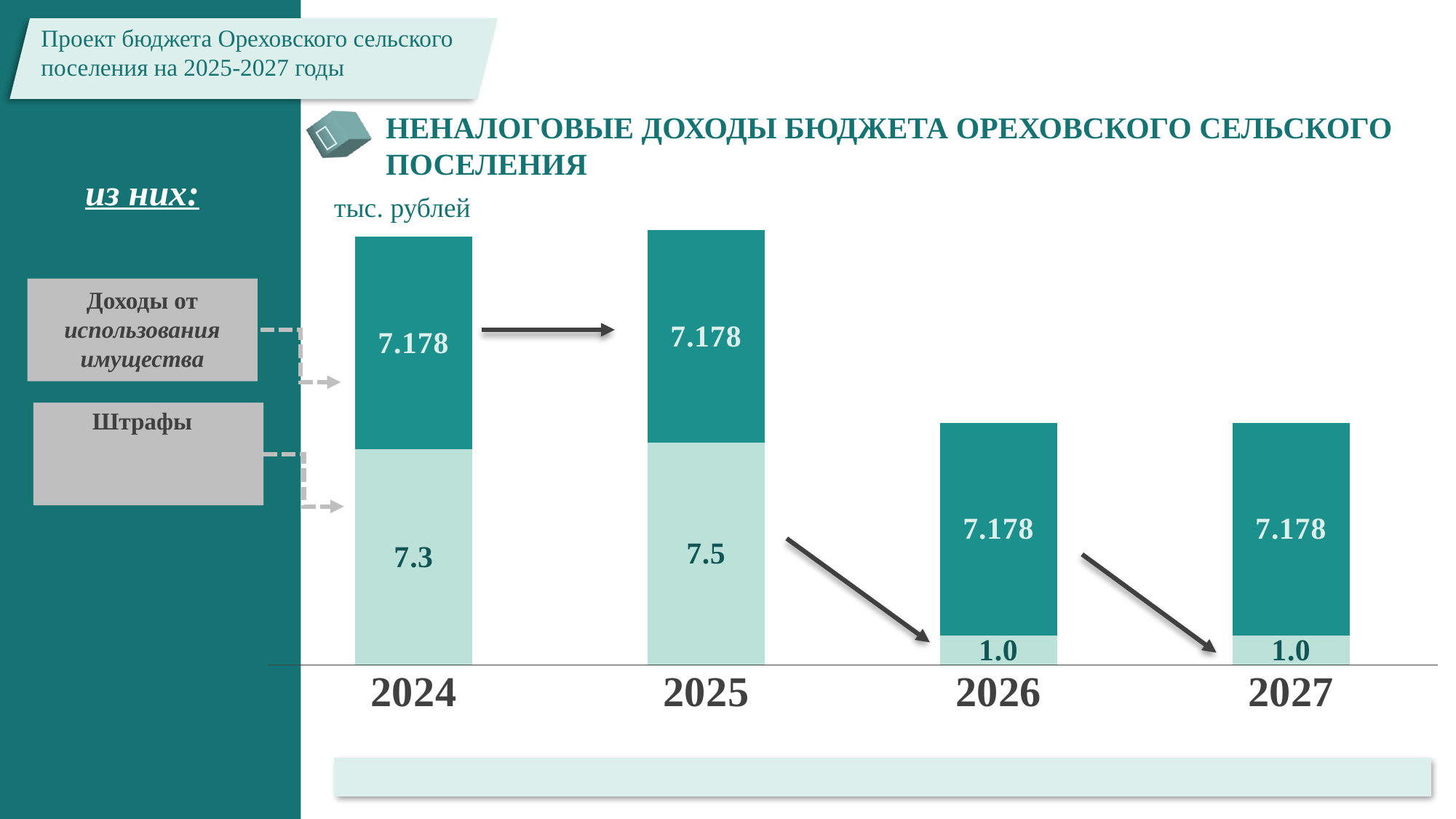
What type of chart is shown on the slide? Stacked bar chart In which years is the value of Штрафы lowest? 2026 and 2027 What is the difference between the Штрафы values for 2025 and 2024? 0.2 What is the value of Штрафы for 2027? 1.0 In which year is the value of Штрафы highest? 2025 How many series are shown in the stacked bars? 2 What is the value of Штрафы for 2024? 7.3 Does the value of Штрафы rise or fall from 2025 to 2027? Falls Which year has the larger Штрафы value, 2024 or 2026? 2024 How many years are shown on the x axis of the chart? 4 What is the value of Штрафы for 2025? 7.5 What is the value of Доходы от использования имущества for 2026? 7.178